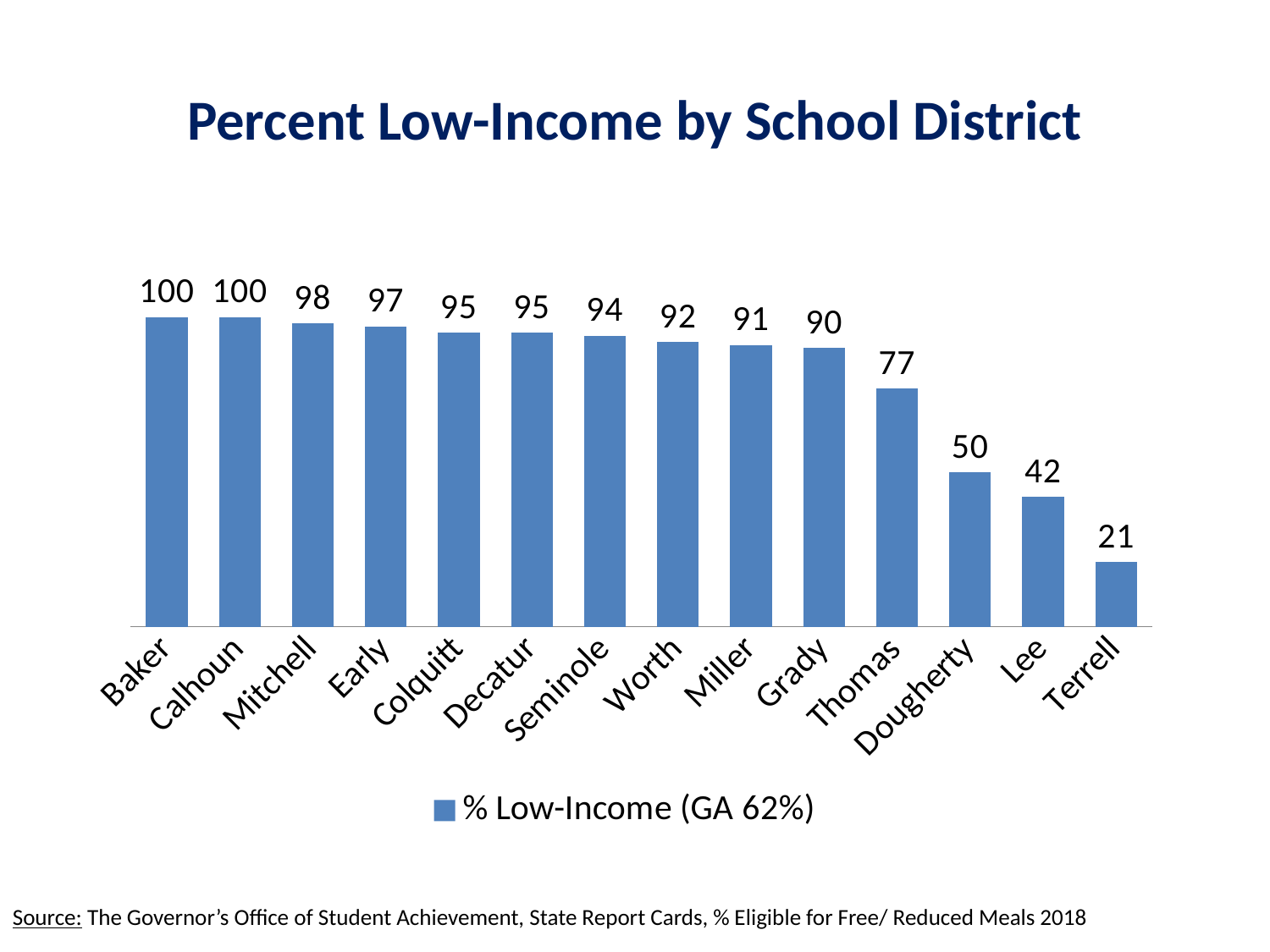
What is the difference between the values for Grady and Lee? 48 What is the title of the chart? Percent Low-Income by School District What is the percent low-income value for Seminole? 94 How many school districts are shown on the chart? 14 What is the percent low-income value for Dougherty? 50 Which has a higher percent low-income, Mitchell or Miller? Mitchell What kind of chart is shown on the slide? Bar chart What is the percent low-income value for Thomas? 77 Do the values rise or fall moving from left to right along the x axis? Fall What is the legend entry for the series shown? % Low-Income (GA 62%) Which school district has the lowest percent low-income? Terrell How many series does the legend list? 1